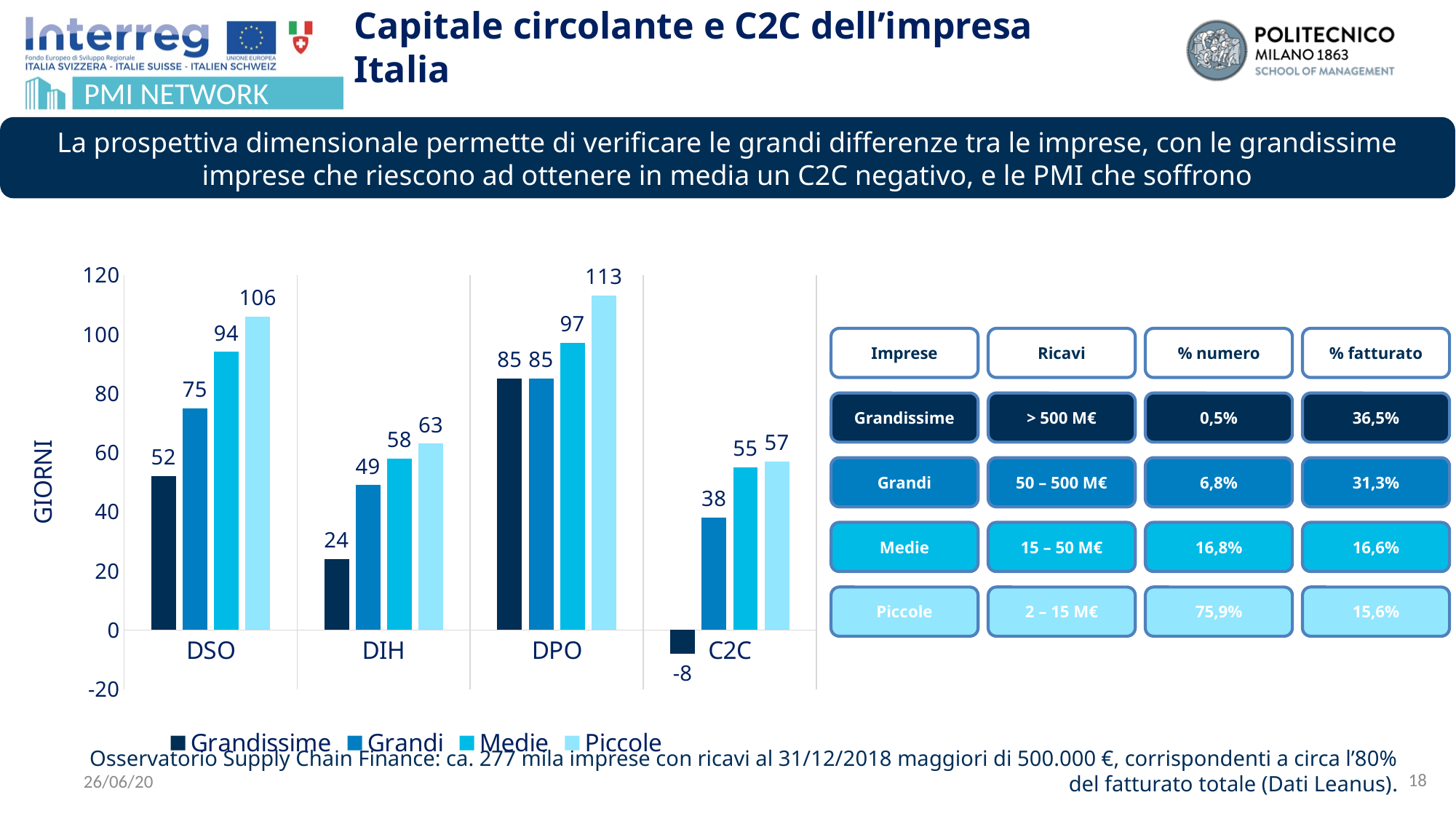
How many series does the chart legend list? 4 Which is larger: the Medie value for DPO or the Medie value for DSO? Medie value for DPO What is the value for Piccole in the DSO category? 106 What is the value for Grandissime in the C2C category? -8 Which series has the highest value in the DPO category? Piccole What is the difference between the Piccole and Grandissime values in the DSO category? 54 Which series has the lowest value in the DIH category? Grandissime Which category contains a bar with a negative value? C2C What is the label of the vertical axis of the chart? GIORNI What is the value for Grandi in the DIH category? 49 How many categories are shown on the x axis of the chart? 4 What kind of chart is shown on the slide? Bar chart